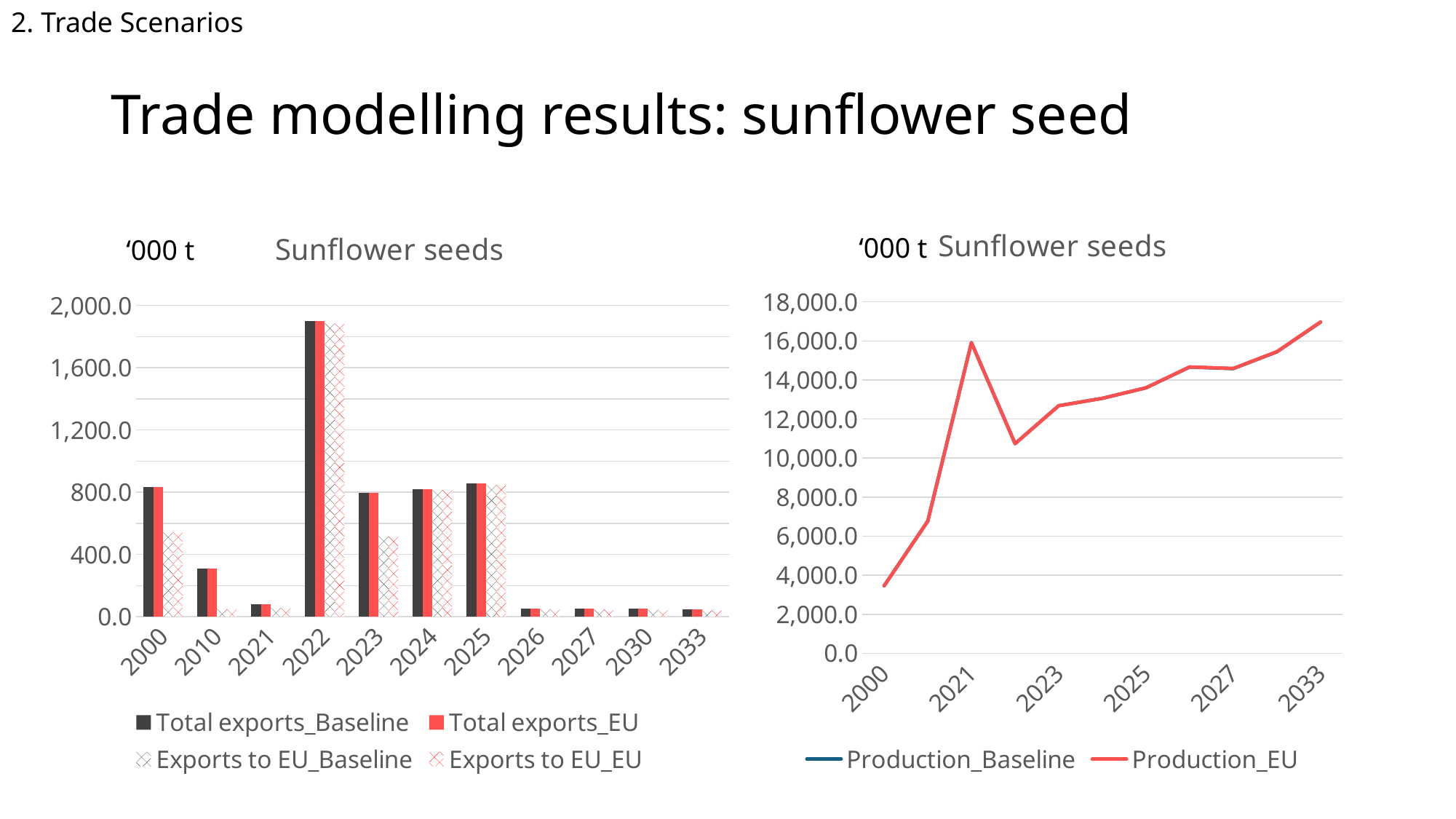
In the left chart, how many series does the legend list? 4 In the left chart, is the Total exports_Baseline value for 2022 greater or less than 1,600.0? greater In the right chart, does Production_EU overall rise or fall from 2000 to 2033? rise In the right chart, is the Production_EU value for 2033 greater or less than 16,000.0? greater In the right chart, how many series does the legend list? 2 In the left chart, how many years are shown on the x axis? 11 In the left chart, is the Total exports_Baseline value for 2010 greater or less than 400.0? less What kind of chart is the right chart on the slide? line chart In the left chart, which year has the highest Total exports_Baseline value? 2022 What kind of chart is the left chart on the slide? bar chart In the left chart, which is larger: Total exports_Baseline for 2000 or for 2010? 2000